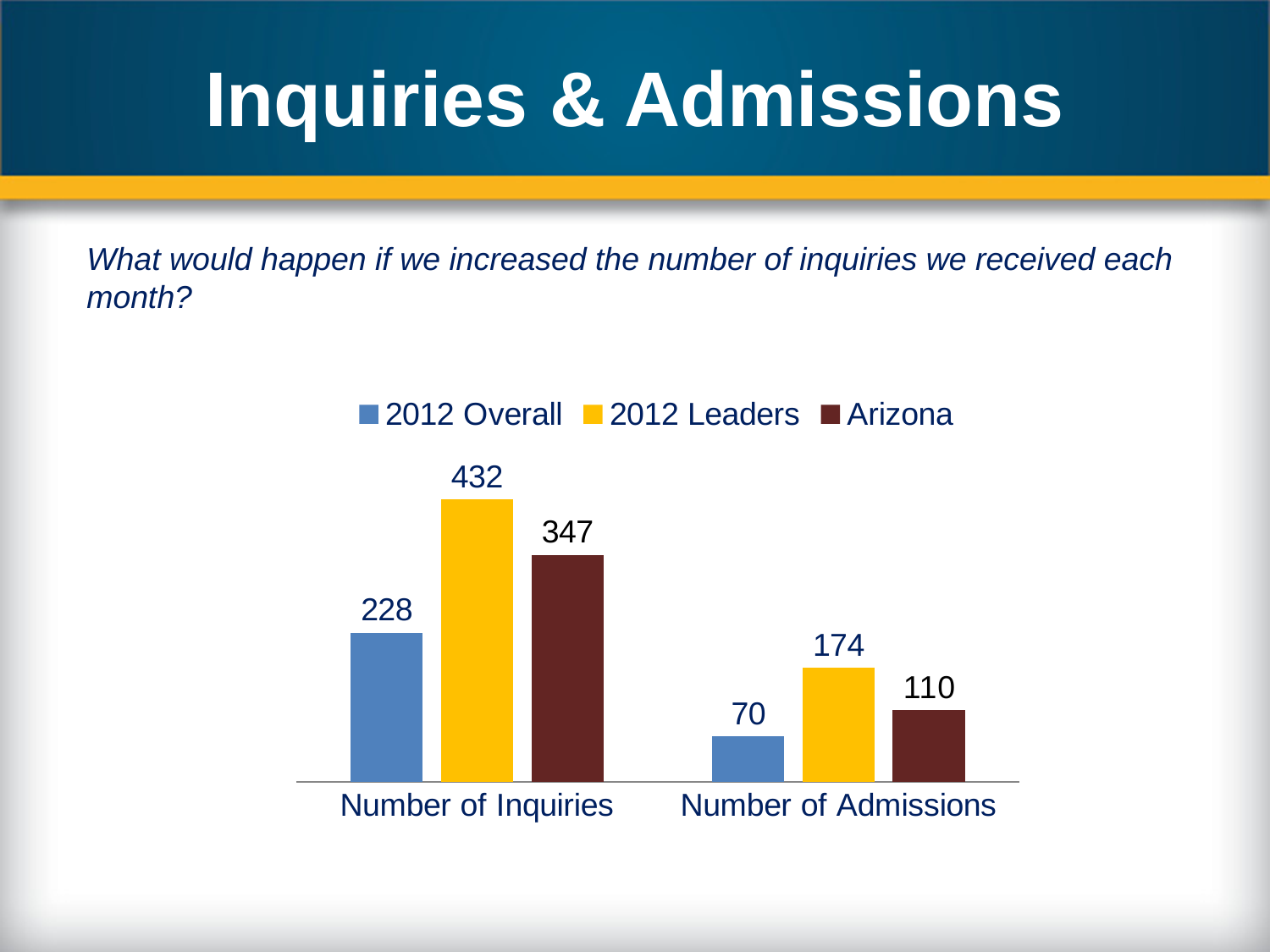
What is the difference between the Arizona and 2012 Overall values for Number of Admissions? 40 How many series does the legend list? 3 Which series is shown in yellow in the legend? 2012 Leaders What is the value for 2012 Overall in the Number of Admissions category? 70 What is the value for 2012 Leaders in the Number of Inquiries category? 432 Which is larger: the Arizona value for Number of Inquiries or the 2012 Overall value for Number of Inquiries? Arizona What kind of chart is shown on the slide? Bar chart What is the difference between the 2012 Leaders and 2012 Overall values for Number of Inquiries? 204 What is the value for Arizona in the Number of Admissions category? 110 How many categories are shown on the x axis? 2 Which series has the highest value in the Number of Inquiries category? 2012 Leaders Which series has the lowest value in the Number of Admissions category? 2012 Overall